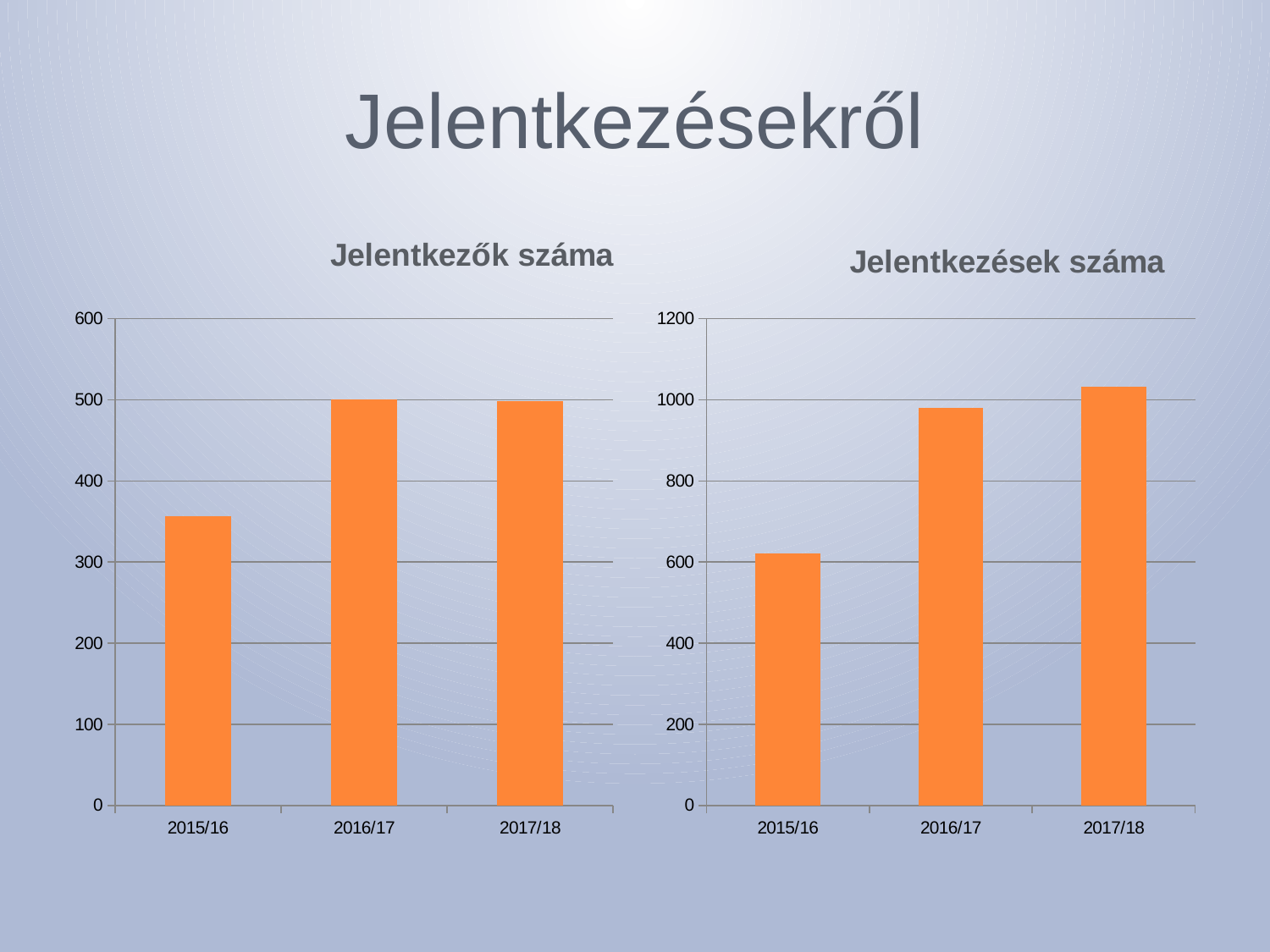
How many categories are shown on the x axis of the 'Jelentkezések száma' chart? 3 In the 'Jelentkezők száma' chart, which year has the lowest value? 2015/16 In the 'Jelentkezések száma' chart, do the values rise or fall from 2015/16 to 2017/18? rise In the 'Jelentkezések száma' chart, is the value for 2017/18 greater or less than 1000? greater What kind of chart is the 'Jelentkezők száma' chart? bar chart In the 'Jelentkezések száma' chart, is the value for 2015/16 greater or less than 800? less In the 'Jelentkezések száma' chart, which year has the highest value? 2017/18 In the 'Jelentkezők száma' chart, is the value for 2015/16 greater or less than 400? less In the 'Jelentkezések száma' chart, which year has the lowest value? 2015/16 In the 'Jelentkezők száma' chart, which is larger: the value for 2015/16 or the value for 2016/17? 2016/17